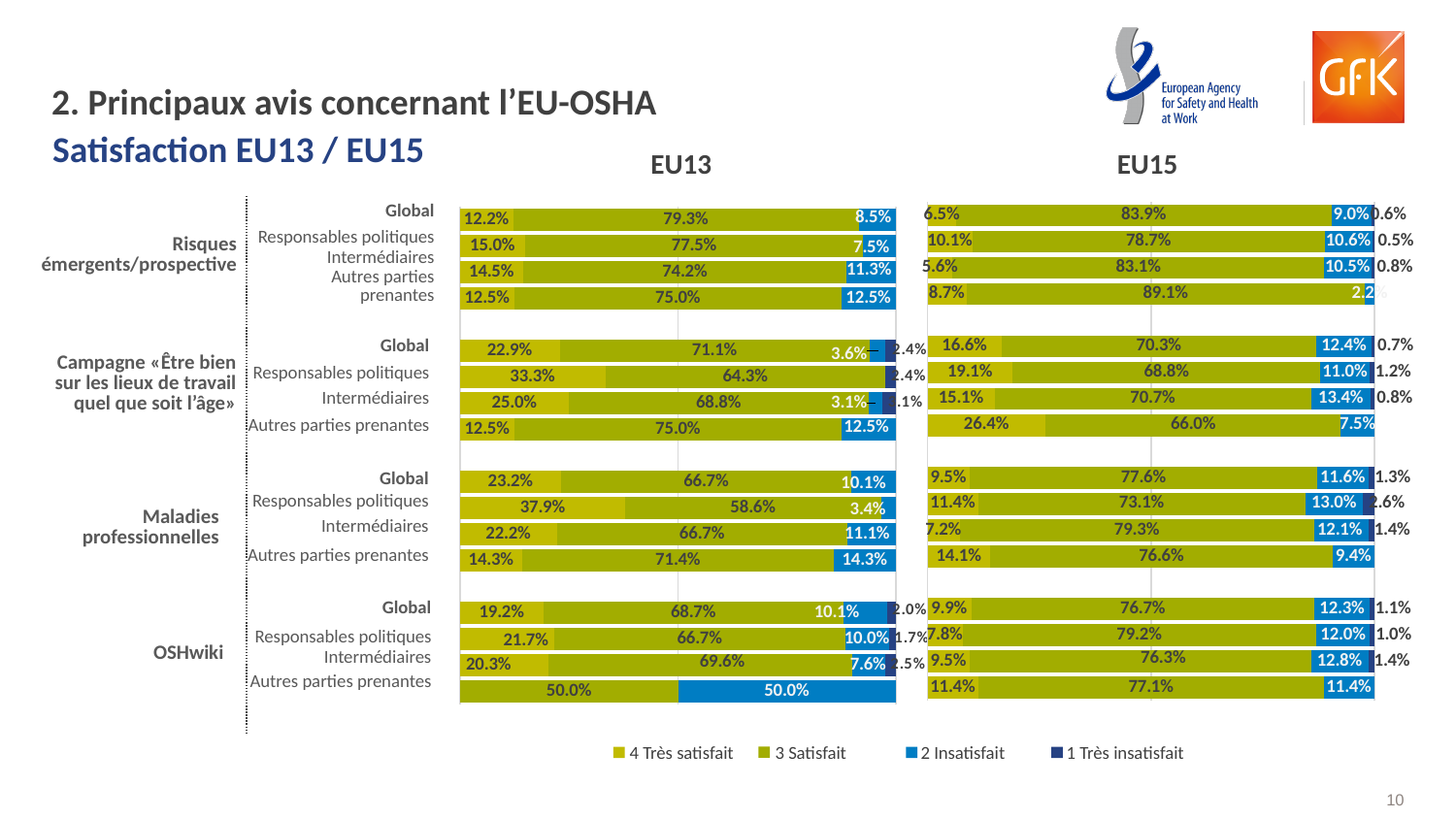
In the EU13 chart, what is the '2 Insatisfait' value for Autres parties prenantes under OSHwiki? 50.0% In the EU15 chart, what is the '4 Très satisfait' value for Autres parties prenantes under Campagne «Être bien sur les lieux de travail quel que soit l'âge»? 26.4% In the EU13 chart, what is the '4 Très satisfait' value for Responsables politiques under Maladies professionnelles? 37.9% In the EU13 chart, what is the '3 Satisfait' value for Global under Risques émergents/prospective? 79.3% In the EU15 chart, what is the '2 Insatisfait' value for Intermédiaires under Campagne «Être bien sur les lieux de travail quel que soit l'âge»? 13.4% What kind of chart is used for EU13 and EU15? Stacked bar chart Which is larger for Global under Risques émergents/prospective, the '3 Satisfait' value in the EU13 chart or in the EU15 chart? EU15 How many topic groups are shown in each chart? 4 In the EU15 chart, what is the '3 Satisfait' value for Global under Risques émergents/prospective? 83.9% How many series does the legend list for the charts? 4 In the EU13 chart, under which topic do Responsables politiques have the highest '4 Très satisfait' value? Maladies professionnelles In the EU13 chart, what is the difference in '4 Très satisfait' between Responsables politiques (37.9%) and Global (23.2%) under Maladies professionnelles? 14.7 percentage points